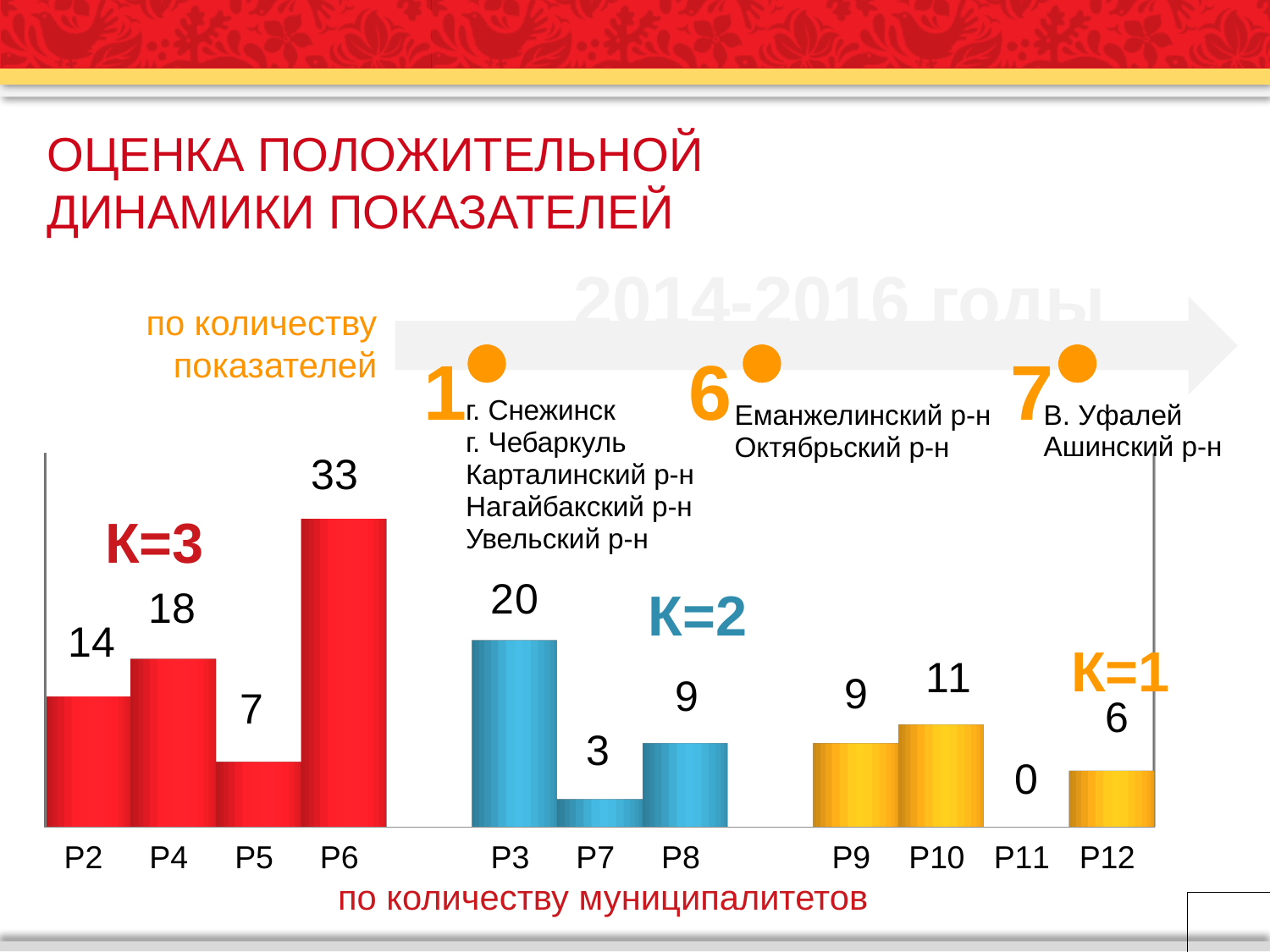
Which category has the lowest value on the chart? Р11 What is the value for Р7 on the chart? 3 Which category has the highest value on the chart? Р6 What is the total of the values for Р9, Р10, Р11 and Р12? 26 What is the value for Р11 on the chart? 0 What is the difference between the values for Р6 and Р3? 13 What label is shown below the x axis of the chart? по количеству муниципалитетов How many categories are shown on the x axis of the chart? 11 What is the value for Р6 on the chart? 33 What is the difference between the values for Р4 and Р5? 11 What kind of chart is shown on the slide? bar chart Which is larger, the value for Р4 or the value for Р10? Р4